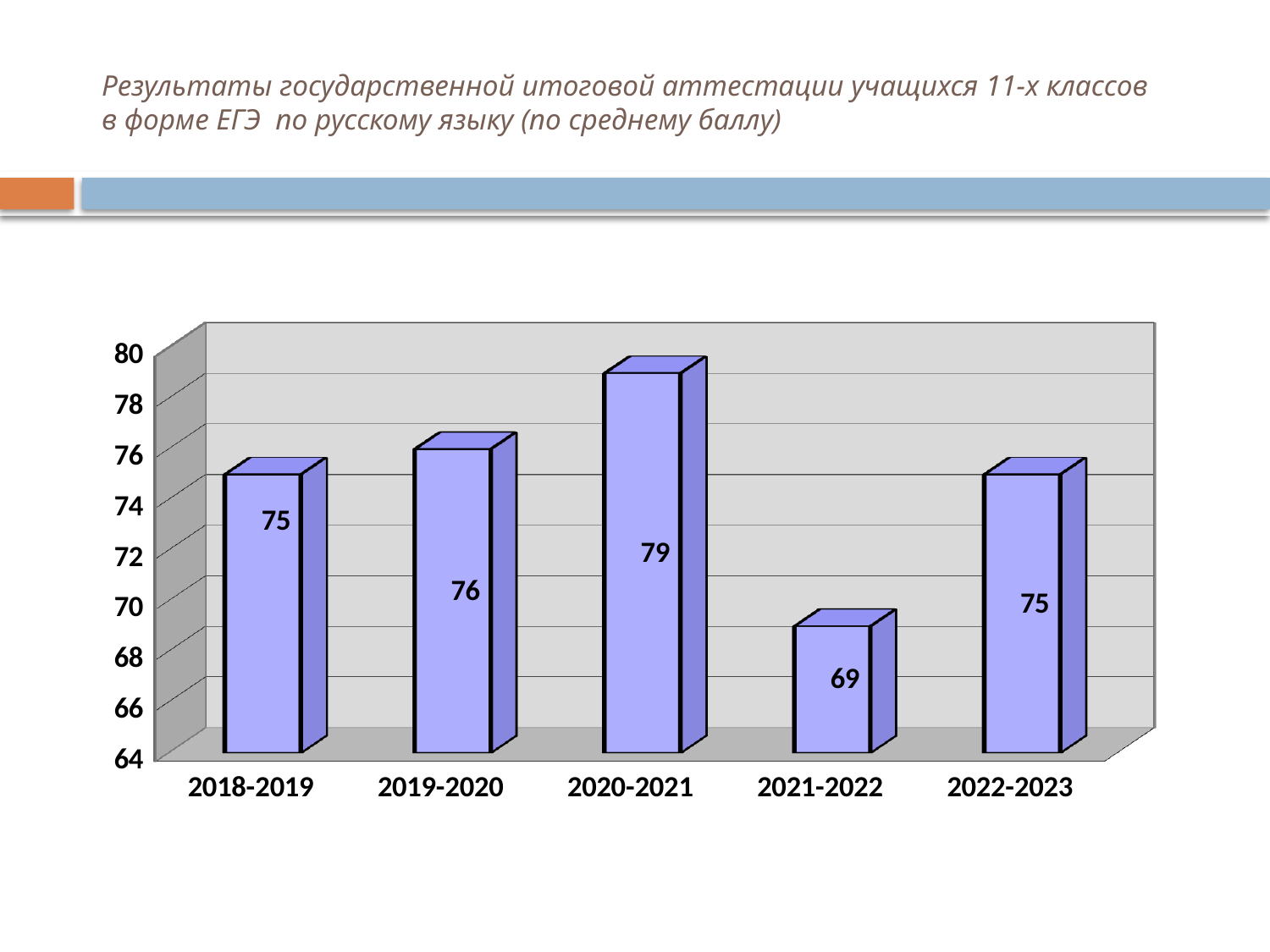
What is the value for 2019-2020? 76 What is the value for 2020-2021? 79 What is the value for 2021-2022? 69 Is the value for 2021-2022 greater or less than 70? less Which is larger, the value for 2019-2020 or the value for 2022-2023? 2019-2020 Do the values rise or fall from 2018-2019 to 2020-2021? rise What is the difference between the values for 2019-2020 and 2018-2019? 1 What kind of chart is shown on the slide? bar chart Which academic year has the lowest value? 2021-2022 Which academic year has the highest value? 2020-2021 What is the difference between the values for 2020-2021 and 2021-2022? 10 How many academic years are shown on the x axis? 5